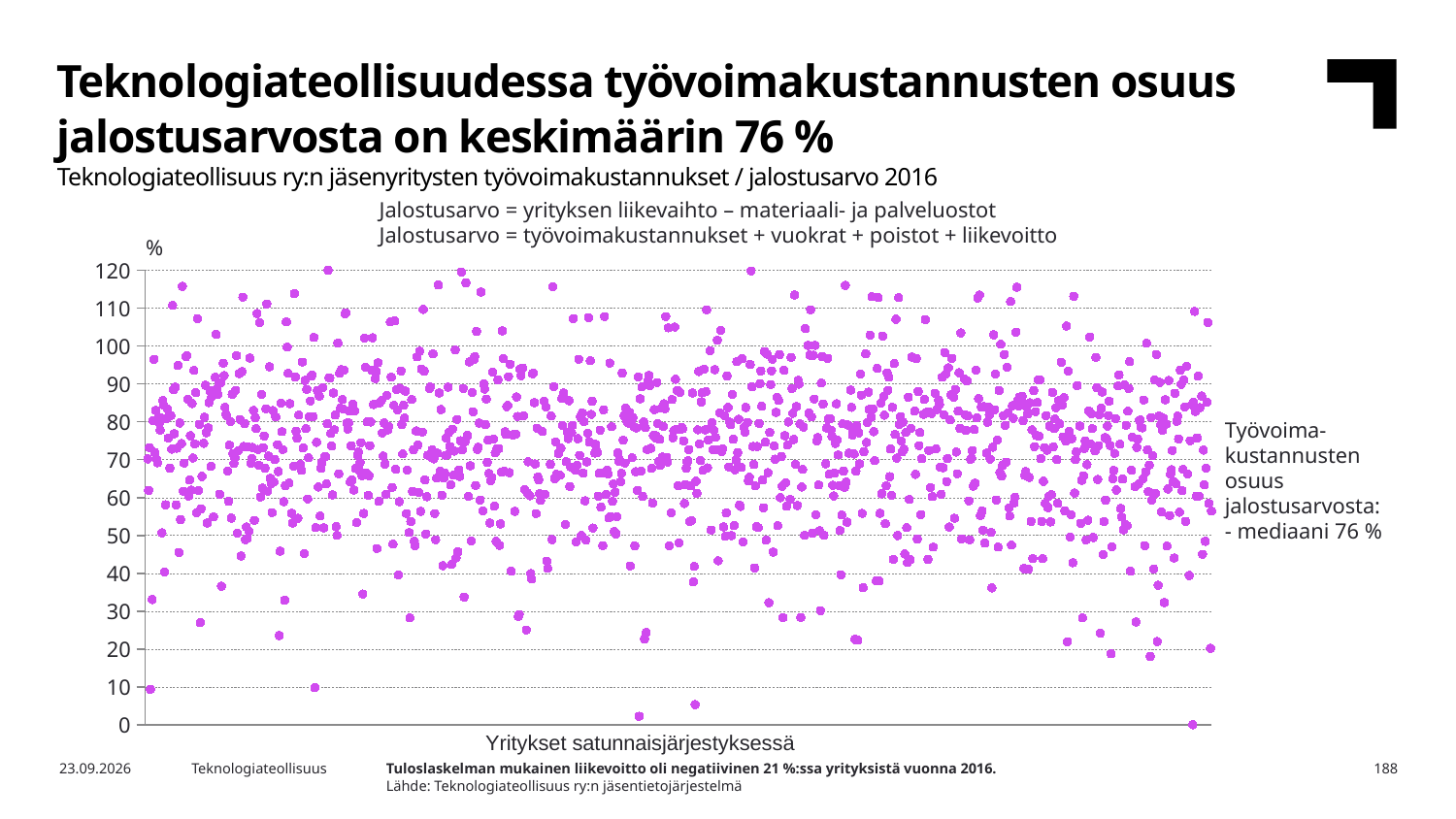
What unit is shown at the top of the y axis of the chart? % Which year does the chart's data refer to? 2016 What kind of chart is shown on the slide? scatter chart What is the label of the x axis of the chart? Yritykset satunnaisjärjestyksessä According to the note below the chart, in what share of companies was the operating profit negative in 2016? 21 % According to the annotation on the chart, what is the median share of labour costs in value added? 76 %